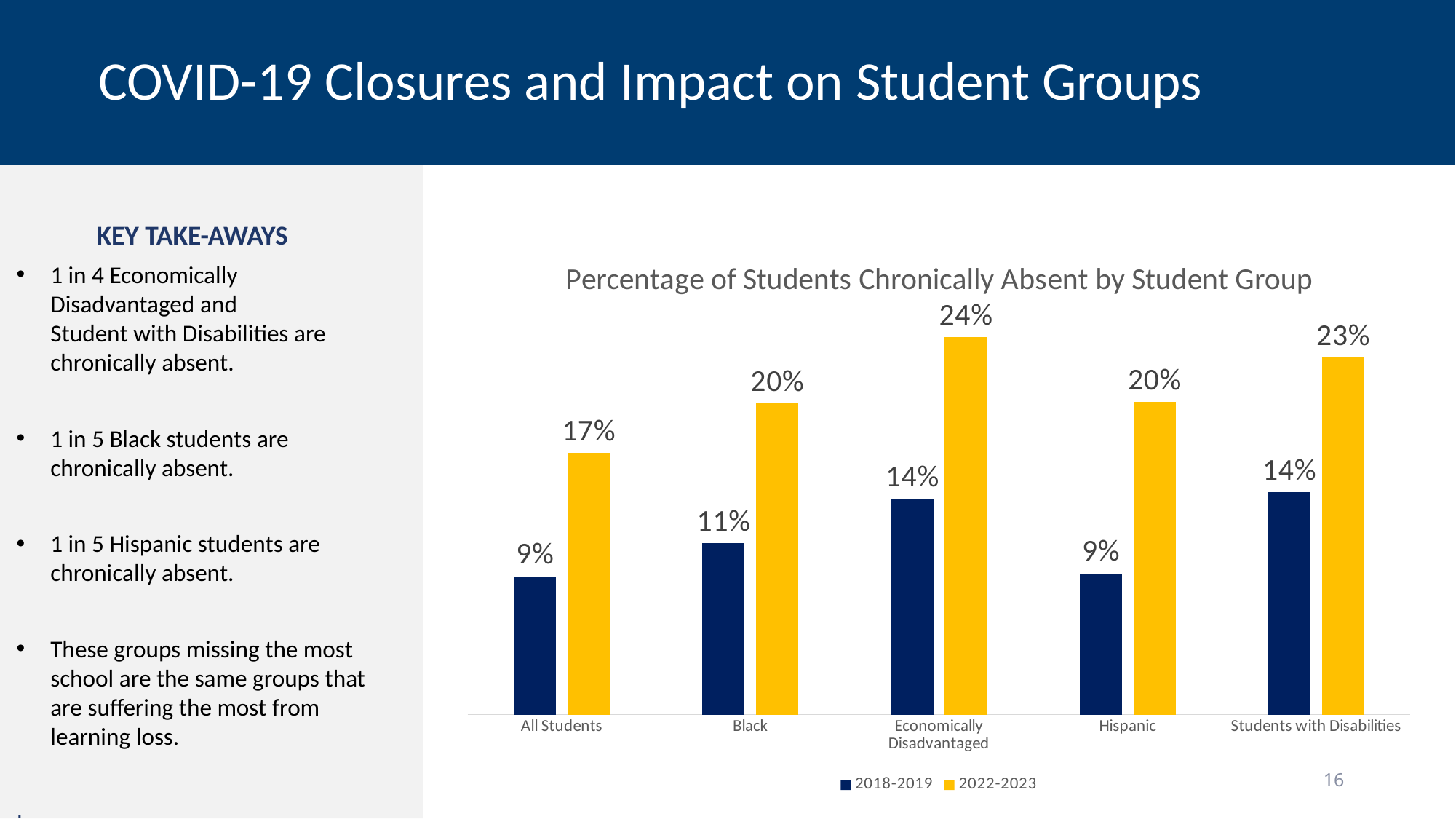
What is the title of the chart? Percentage of Students Chronically Absent by Student Group What is the difference between the 2022-2023 and 2018-2019 values for Students with Disabilities? 9% What is the 2018-2019 value for Black students? 11% What is the 2022-2023 value for All Students? 17% What is the 2022-2023 value for Economically Disadvantaged students? 24% How many series does the legend list? 2 How many student groups are shown on the x axis? 5 What is the difference between the 2022-2023 values for Economically Disadvantaged and Hispanic students? 4% Which is larger: the 2018-2019 value for Black students or the 2018-2019 value for Hispanic students? Black What kind of chart is shown on the slide? Bar chart Which student group has the lowest 2022-2023 value? All Students Which student group has the highest 2022-2023 value? Economically Disadvantaged